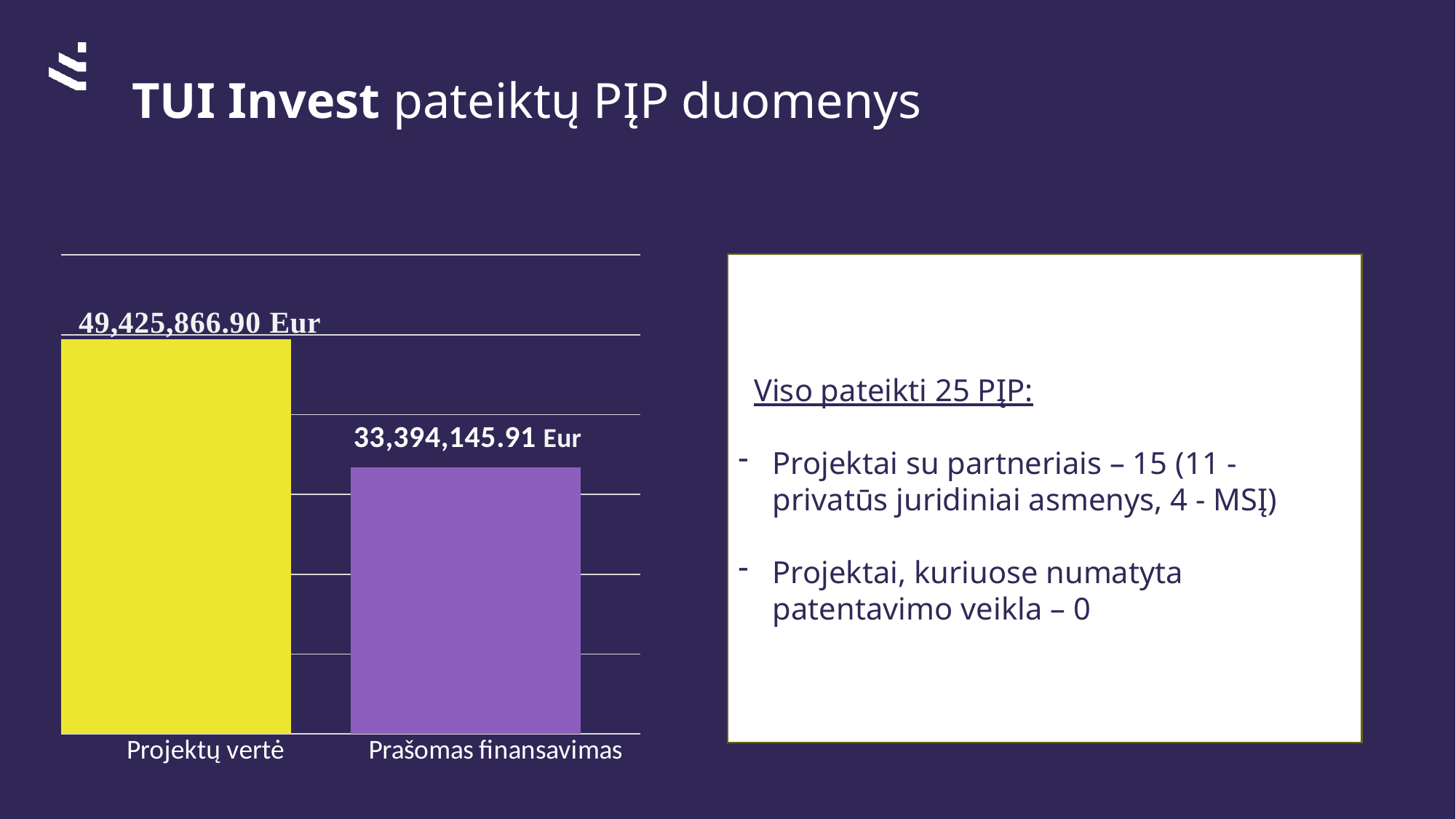
How many categories are shown in the chart? 2 What is the difference between Projektų vertė and Prašomas finansavimas? 16,031,720.99 Eur Which is larger, Projektų vertė or Prašomas finansavimas? Projektų vertė What kind of chart is shown on the slide? Bar chart What is the value for Projektų vertė? 49,425,866.90 Eur What colour is the bar for Projektų vertė? Yellow Which category has the highest value? Projektų vertė Which category has the lowest value? Prašomas finansavimas What is the value for Prašomas finansavimas? 33,394,145.91 Eur What colour is the bar for Prašomas finansavimas? Purple